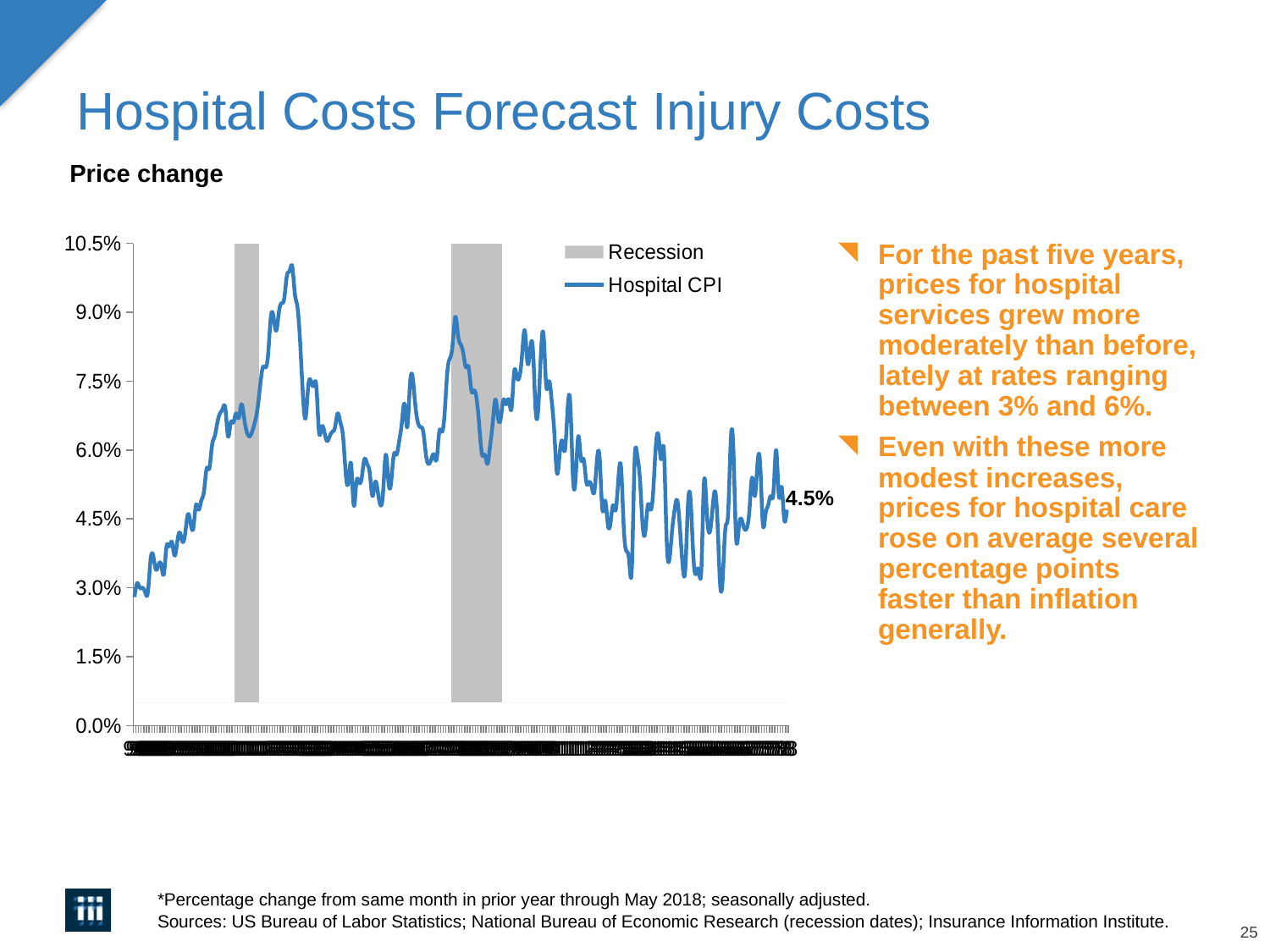
What is the value shown by the data label at the end of the Hospital CPI line? 4.5% Is the highest point of the Hospital CPI line greater or less than 9.0%? greater Is the final labelled value of the Hospital CPI line greater or less than 6.0%? less How many grey recession bands are shaded on the chart? 2 How many entries does the chart legend list? 2 What kind of chart is used to show Hospital CPI? Line chart What is the highest tick value shown on the y-axis? 10.5% What is the subtitle printed above the chart? Price change Over the right-hand half of the chart, does the Hospital CPI line generally rise or fall? fall Is the Hospital CPI value at the start of the line greater or less than 4.5%? less What are the two entries in the chart legend? Recession and Hospital CPI